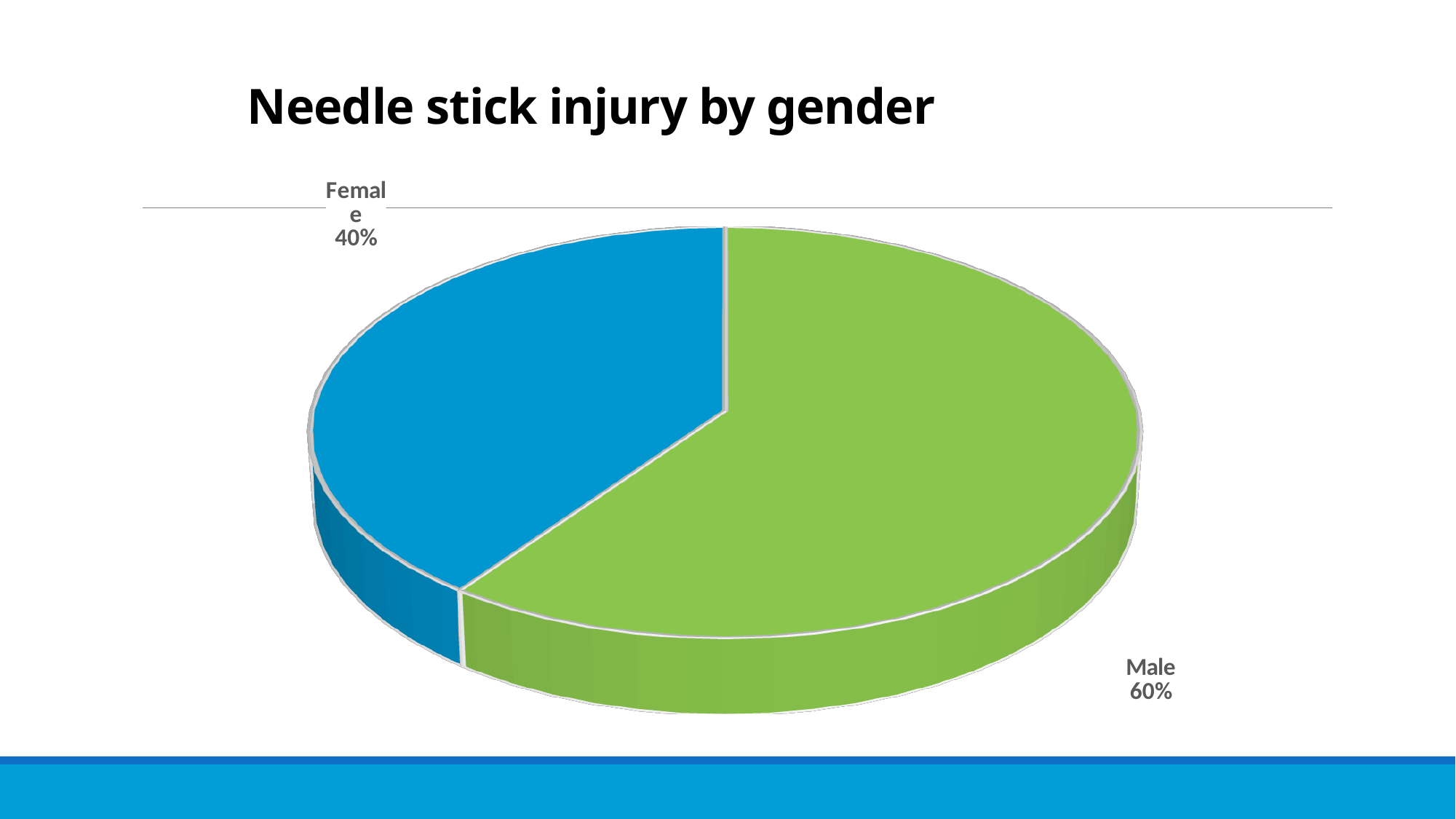
What share of needle stick injuries is attributed to Male? 60% What kind of chart is shown on the slide? Pie chart Which is larger, the Male share or the Female share? Male Is the Female share greater or less than 50%? less What is the title of the chart? Needle stick injury by gender What colour is the Male slice of the pie chart? Green Which gender has the largest share of needle stick injuries? Male What share of needle stick injuries is attributed to Female? 40% How many categories does the pie chart show? 2 What is the difference in percentage points between the Male and Female shares? 20% Which gender has the smallest share of needle stick injuries? Female